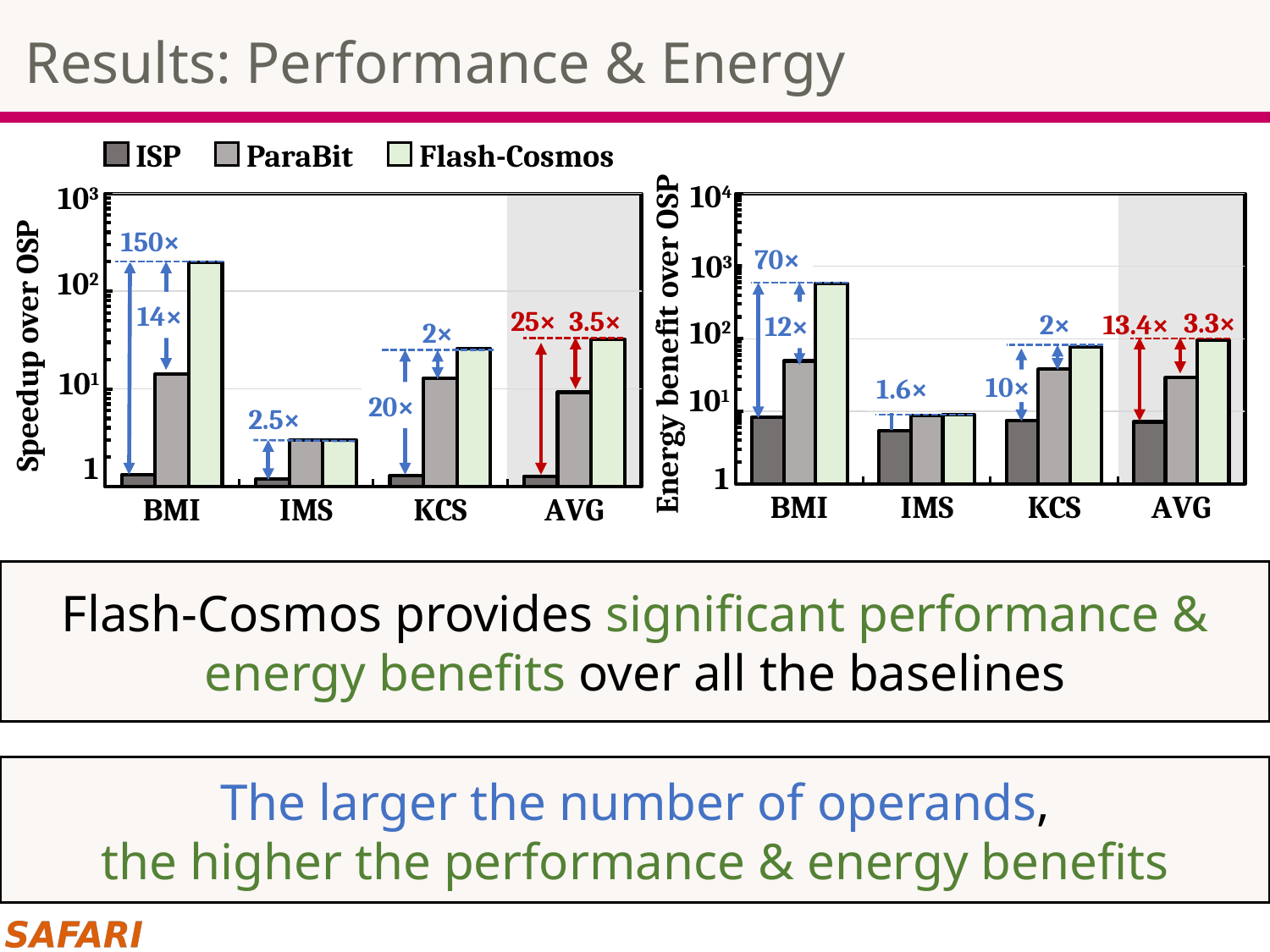
In the left chart (Speedup over OSP), is the Flash-Cosmos value for BMI greater or less than 100? greater In the left chart (Speedup over OSP), what speedup factor is annotated between ISP and Flash-Cosmos for BMI? 150× How many series does the shared legend list for the two charts? 3 How many categories are shown on the x axis of the right chart (Energy benefit over OSP)? 4 In the left chart (Speedup over OSP), what factor is annotated between ParaBit and Flash-Cosmos for AVG? 3.5× In the right chart (Energy benefit over OSP), what factor is annotated for IMS? 1.6× In the right chart (Energy benefit over OSP), which category has the lowest Flash-Cosmos bar? IMS In the left chart (Speedup over OSP), which category has the highest Flash-Cosmos bar? BMI In the left chart (Speedup over OSP), which is larger: the Flash-Cosmos bar for BMI or the Flash-Cosmos bar for KCS? BMI In the right chart (Energy benefit over OSP), what factor is annotated between ISP and Flash-Cosmos for AVG? 13.4× What kind of chart is the left chart titled with the y-axis 'Speedup over OSP'? bar chart